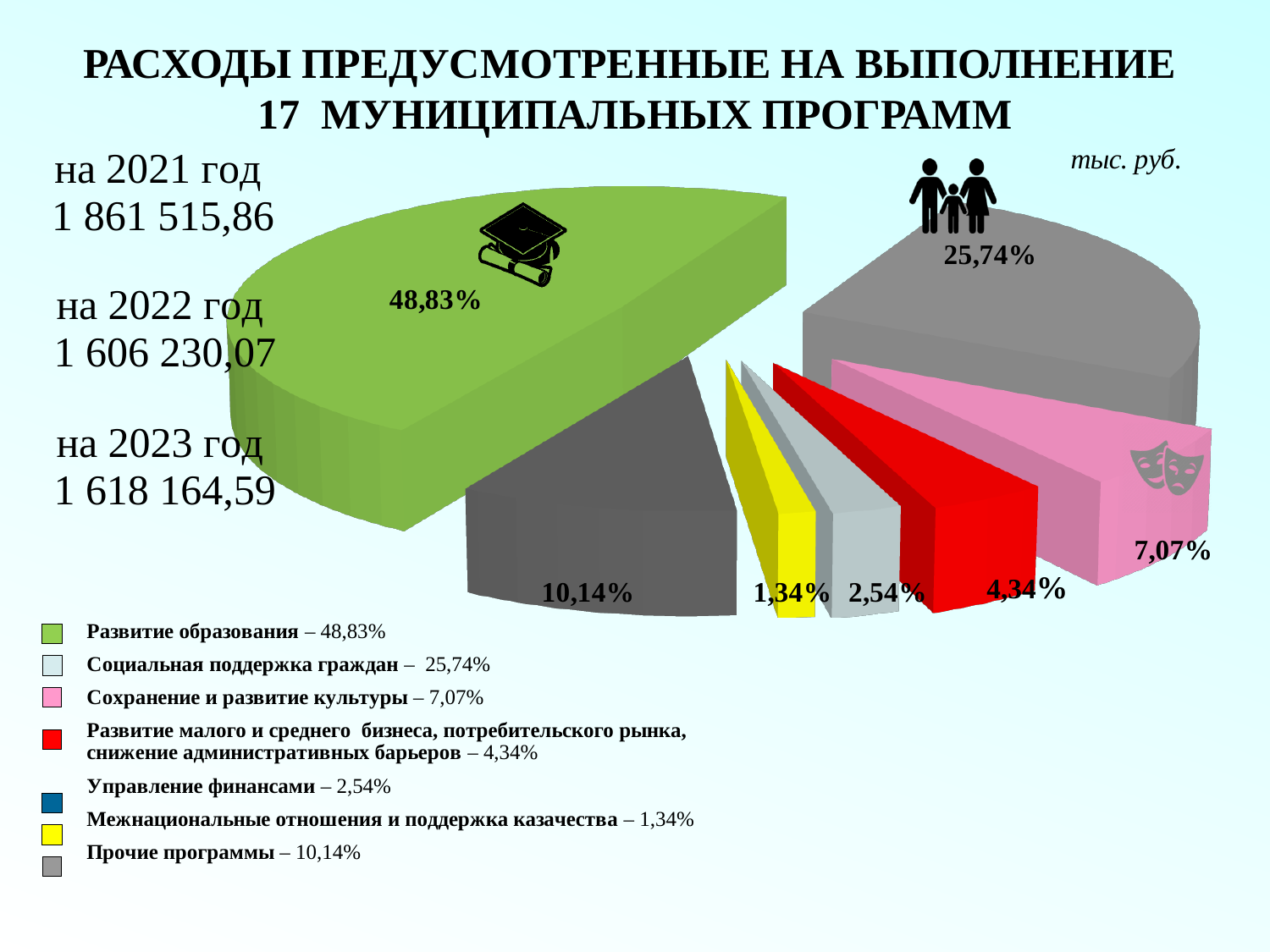
What is the difference in percentage points between the shares for Развитие образования and Социальная поддержка граждан? 23,09 Which category has the smallest slice of the pie? Межнациональные отношения и поддержка казачества What share of the pie does Развитие образования have? 48,83% What share of the pie does Прочие программы have? 10,14% How many slices does the pie chart have? 7 Which is larger: the share for Прочие программы or the share for Сохранение и развитие культуры? Прочие программы What share of the pie does Управление финансами have? 2,54% Which category has the largest slice of the pie? Развитие образования What kind of chart is shown on the slide? pie chart What unit is indicated in the top right corner of the slide? тыс. руб. What share of the pie does Социальная поддержка граждан have? 25,74% What share of the pie does Сохранение и развитие культуры have? 7,07%